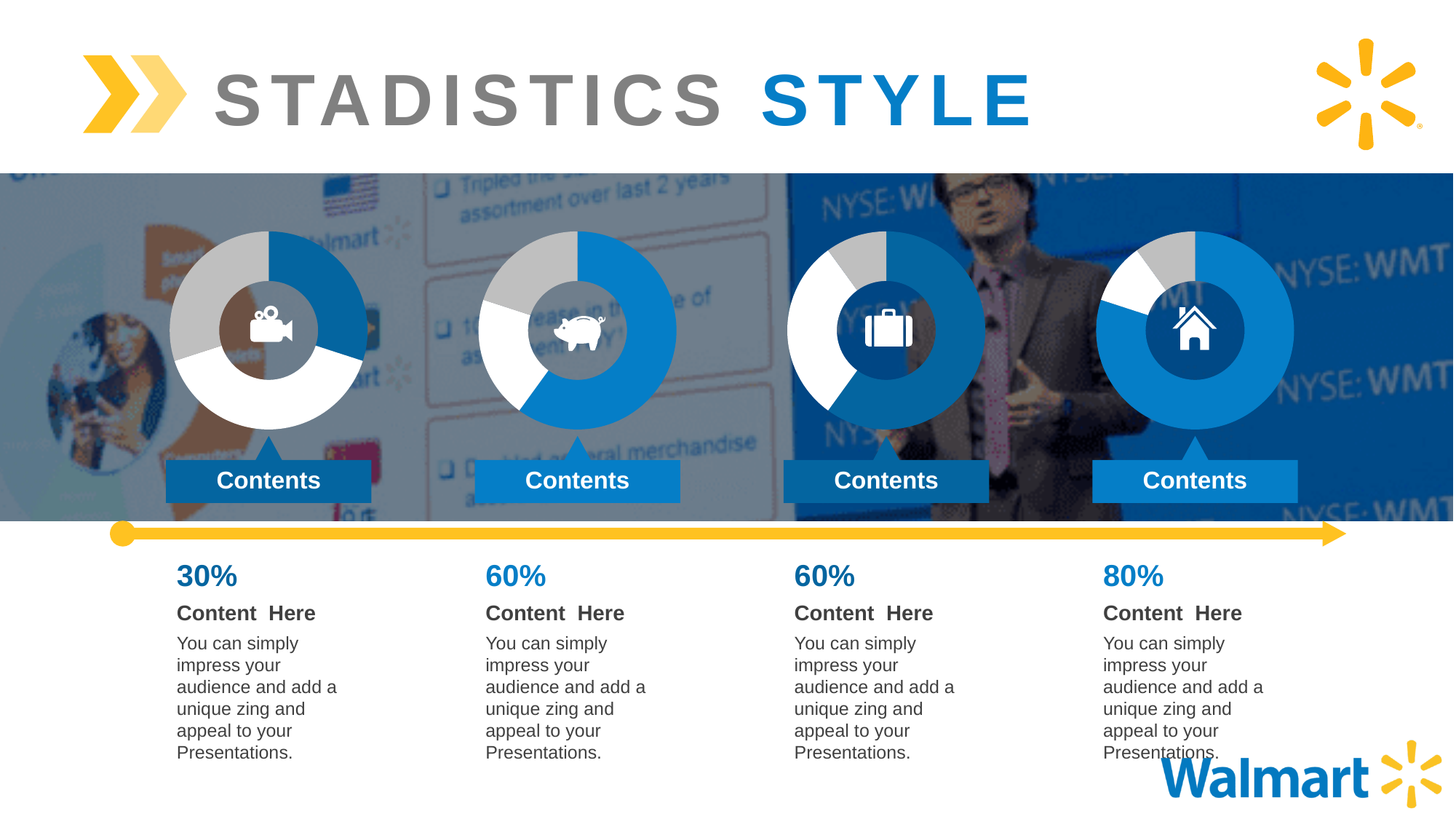
What kind of chart is used for each of the four charts on the slide? Donut (pie) chart Which donut chart has the smallest blue slice? The leftmost (first) chart What percentage is printed below the rightmost donut chart? 80% What is the difference between the percentage printed below the rightmost donut chart and the percentage printed below the leftmost donut chart? 50% How many donut charts are shown on the slide? 4 Is the blue slice larger in the leftmost donut chart or in the rightmost donut chart? The rightmost donut chart What percentage is printed below the leftmost donut chart? 30% How many slices does the leftmost donut chart have? 3 What icon is shown in the centre of the leftmost donut chart? A video camera What label appears in the box directly beneath each donut chart? Contents Which donut chart has the largest blue slice? The rightmost (fourth) chart What percentage is printed below the second donut chart from the left? 60%